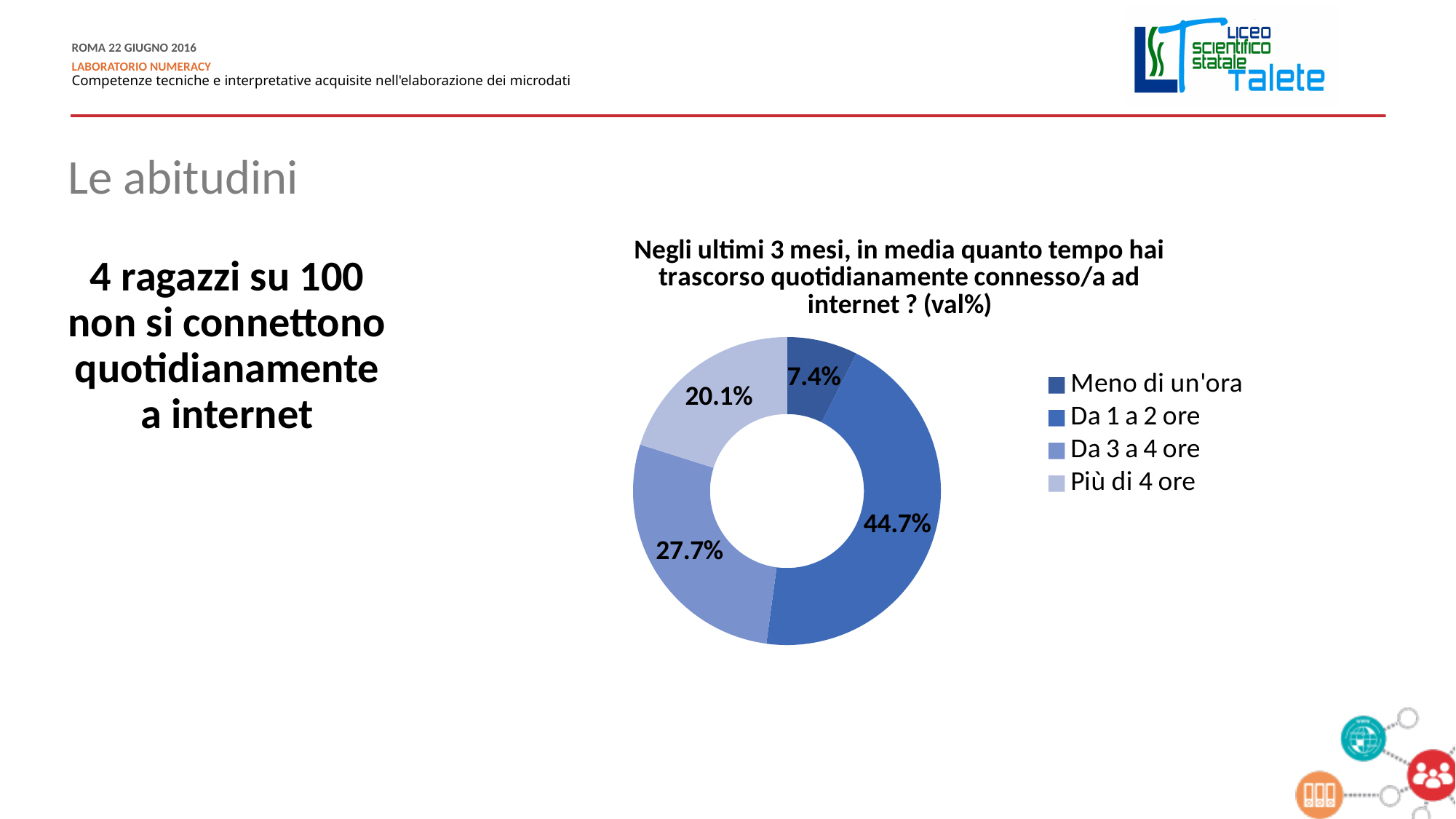
Which category has the smallest share? Meno di un'ora What is the value for 'Meno di un'ora'? 7.4% What kind of chart is shown on the slide? Doughnut (pie) chart Which is larger, the share for 'Da 3 a 4 ore' or for 'Più di 4 ore'? Da 3 a 4 ore Which category has the largest share? Da 1 a 2 ore What is the title of the chart? Negli ultimi 3 mesi, in media quanto tempo hai trascorso quotidianamente connesso/a ad internet ? (val%) What is the value for 'Più di 4 ore'? 20.1% What is the difference between the values for 'Più di 4 ore' and 'Meno di un'ora'? 12.7% How many categories does the legend list? 4 What is the value for 'Da 3 a 4 ore'? 27.7% What is the difference between the values for 'Da 1 a 2 ore' and 'Da 3 a 4 ore'? 17.0% What is the value for 'Da 1 a 2 ore'? 44.7%